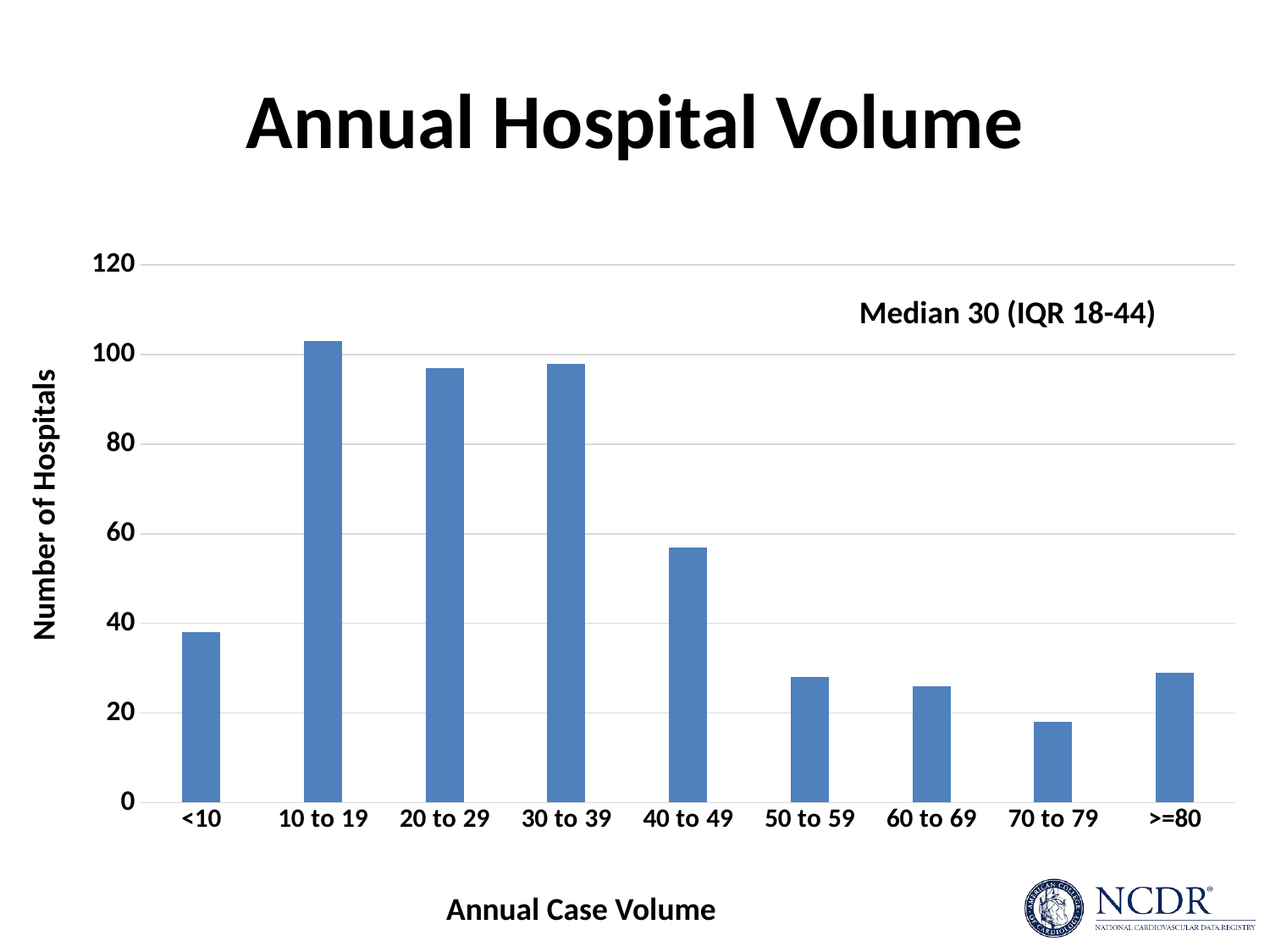
What is the title of the chart? Annual Hospital Volume Is the number of hospitals for the 50 to 59 category greater or less than 20? greater Is the number of hospitals for the 10 to 19 category greater or less than 100? greater Is the number of hospitals for the <10 category greater or less than 40? less Which has more hospitals, the 40 to 49 category or the 50 to 59 category? 40 to 49 What kind of chart is shown on the slide? bar chart How many annual case volume categories are shown on the x axis? 9 What median and IQR are annotated on the chart? Median 30 (IQR 18-44) Which annual case volume category has the highest number of hospitals? 10 to 19 Which annual case volume category has the lowest number of hospitals? 70 to 79